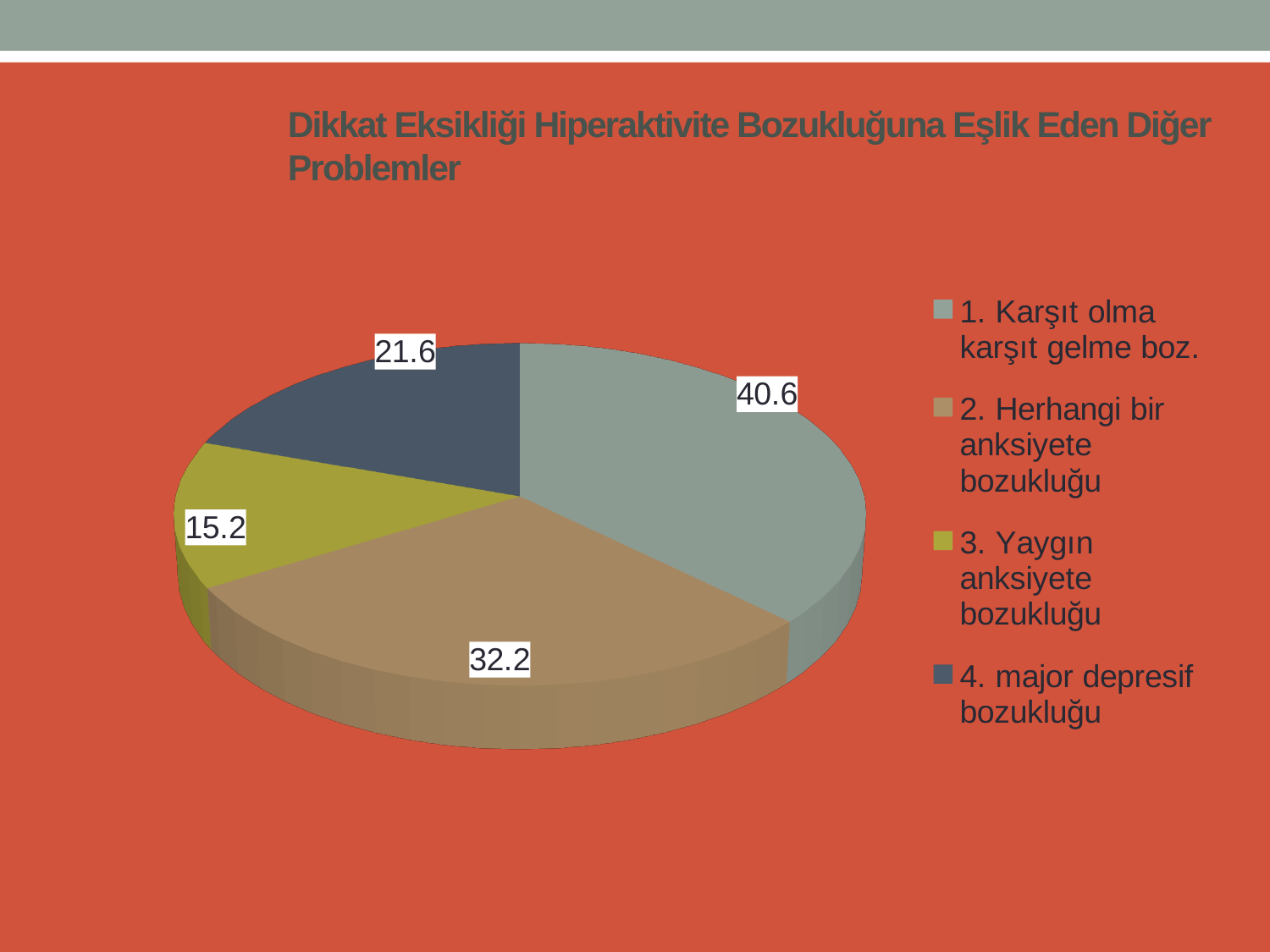
What is the difference between the values for "4. major depresif bozukluğu" and "3. Yaygın anksiyete bozukluğu"? 6.4 Which category has the largest slice of the pie? 1. Karşıt olma karşıt gelme boz. What is the value for "4. major depresif bozukluğu"? 21.6 What kind of chart is shown on the slide? Pie chart What is the value for "3. Yaygın anksiyete bozukluğu"? 15.2 Which category has the smallest slice of the pie? 3. Yaygın anksiyete bozukluğu What is the title of the chart? Dikkat Eksikliği Hiperaktivite Bozukluğuna Eşlik Eden Diğer Problemler Which is larger, the value for "4. major depresif bozukluğu" or the value for "3. Yaygın anksiyete bozukluğu"? 4. major depresif bozukluğu What is the difference between the values for "1. Karşıt olma karşıt gelme boz." and "2. Herhangi bir anksiyete bozukluğu"? 8.4 What is the value for "2. Herhangi bir anksiyete bozukluğu"? 32.2 How many categories does the pie chart have? 4 What is the value for "1. Karşıt olma karşıt gelme boz."? 40.6